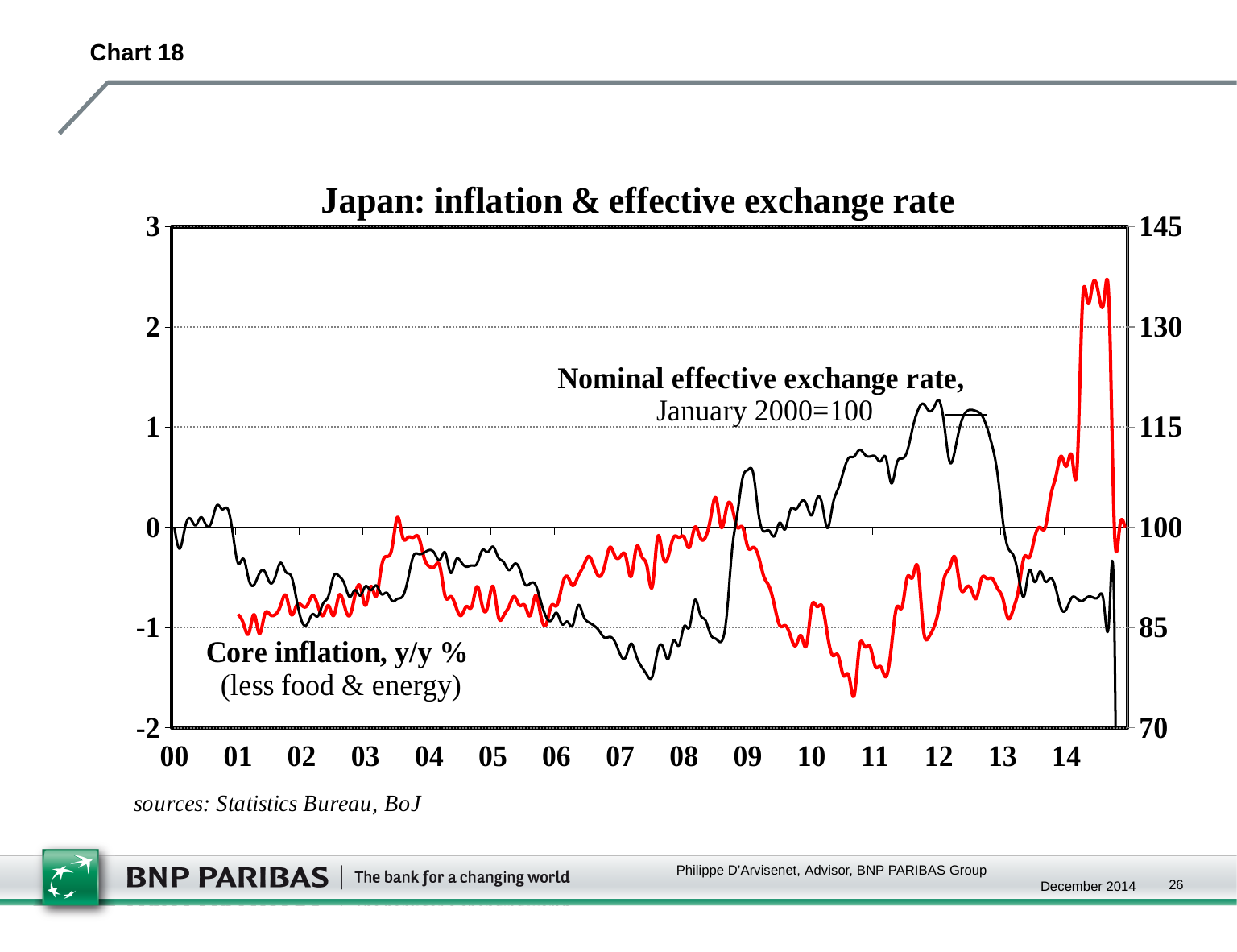
What is the title of the chart? Japan: inflation & effective exchange rate Which is higher: the peak of core inflation in 2014 or the peak of core inflation in 2008? 2014 How many year labels are shown on the x axis? 15 Is the nominal effective exchange rate in mid-2007 greater or less than 85? less What is the base period for the nominal effective exchange rate index? January 2000=100 Does the nominal effective exchange rate rise or fall between 2012 and 2014? fall What kind of chart is shown on the slide? line chart How many data series are plotted on the chart? 2 Is the lowest value of core inflation around late 2010 greater or less than -1? less Is the peak of the nominal effective exchange rate in 2012 greater or less than 115? greater Does core inflation rise or fall between 2013 and mid-2014? rise